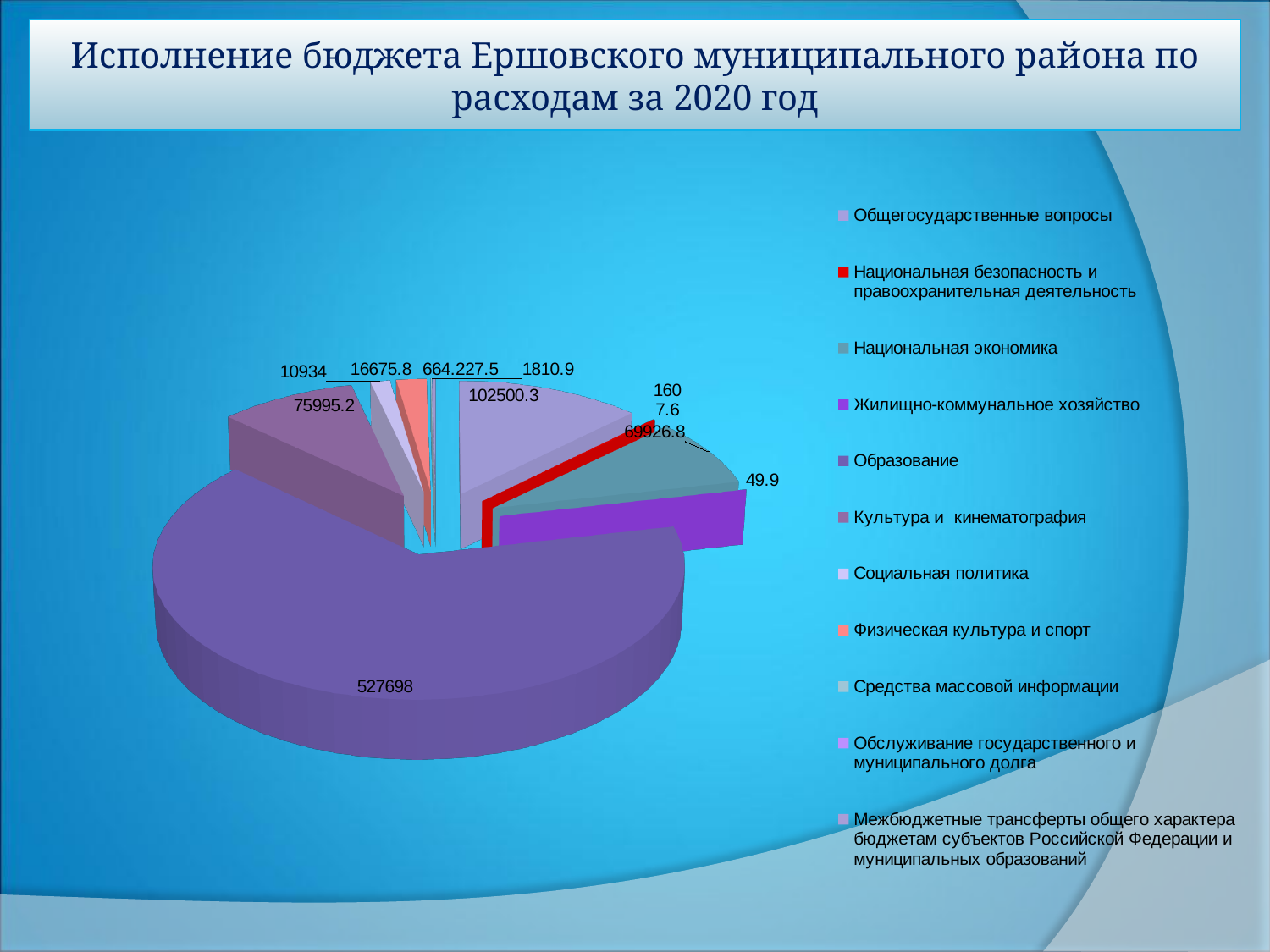
How many entries does the chart legend list? 11 What is the difference between the values for Общегосударственные вопросы and Национальная экономика? 32573.5 What kind of chart is shown on the slide? Pie chart What colour is the slice for Образование? Purple What is the value shown for Национальная экономика? 69926.8 What is the value shown for Образование? 527698 Which category has the largest slice of the pie? Образование Which is larger: Общегосударственные вопросы or Национальная экономика? Общегосударственные вопросы What is the title of the chart on the slide? Исполнение бюджета Ершовского муниципального района по расходам за 2020 год What is the difference between the values for Образование and Общегосударственные вопросы? 425197.7 What is the value shown for Общегосударственные вопросы? 102500.3